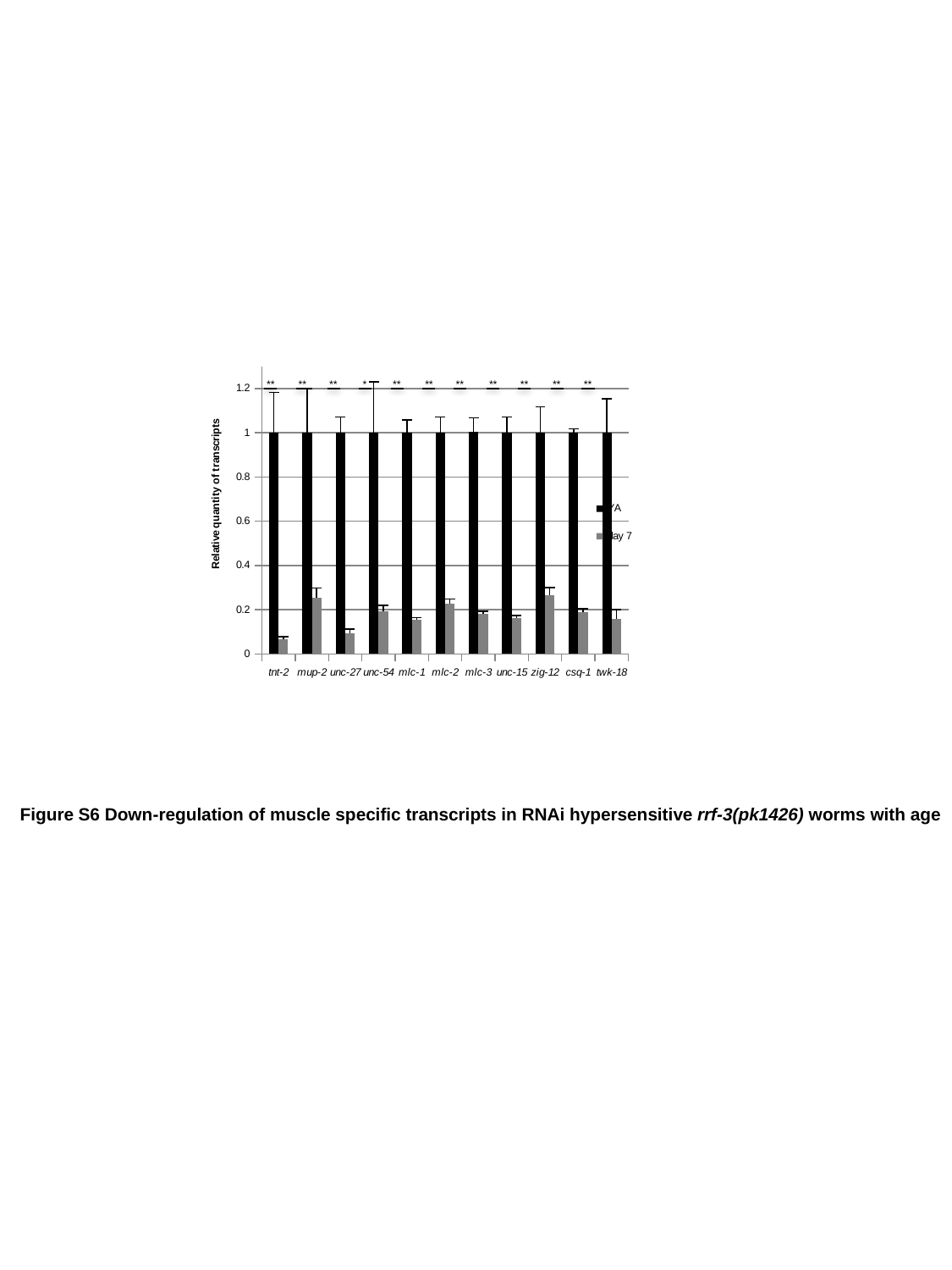
Is the gray bar for zig-12 greater or less than 0.2? greater How many series does the chart's legend list? 2 For mlc-2, which bar is larger, the black bar or the gray bar? the black bar Is the gray bar for mup-2 greater or less than 0.2? greater Is the gray bar for tnt-2 greater or less than 0.2? less What is the value of the black (YA) bar for tnt-2? 1 Which category has the lowest gray bar? tnt-2 What is the title of the chart's y axis? Relative quantity of transcripts What kind of chart is shown on the slide? bar chart How many gene categories are shown along the x axis of the chart? 11 Which is larger, the gray bar for tnt-2 or the gray bar for mup-2? mup-2